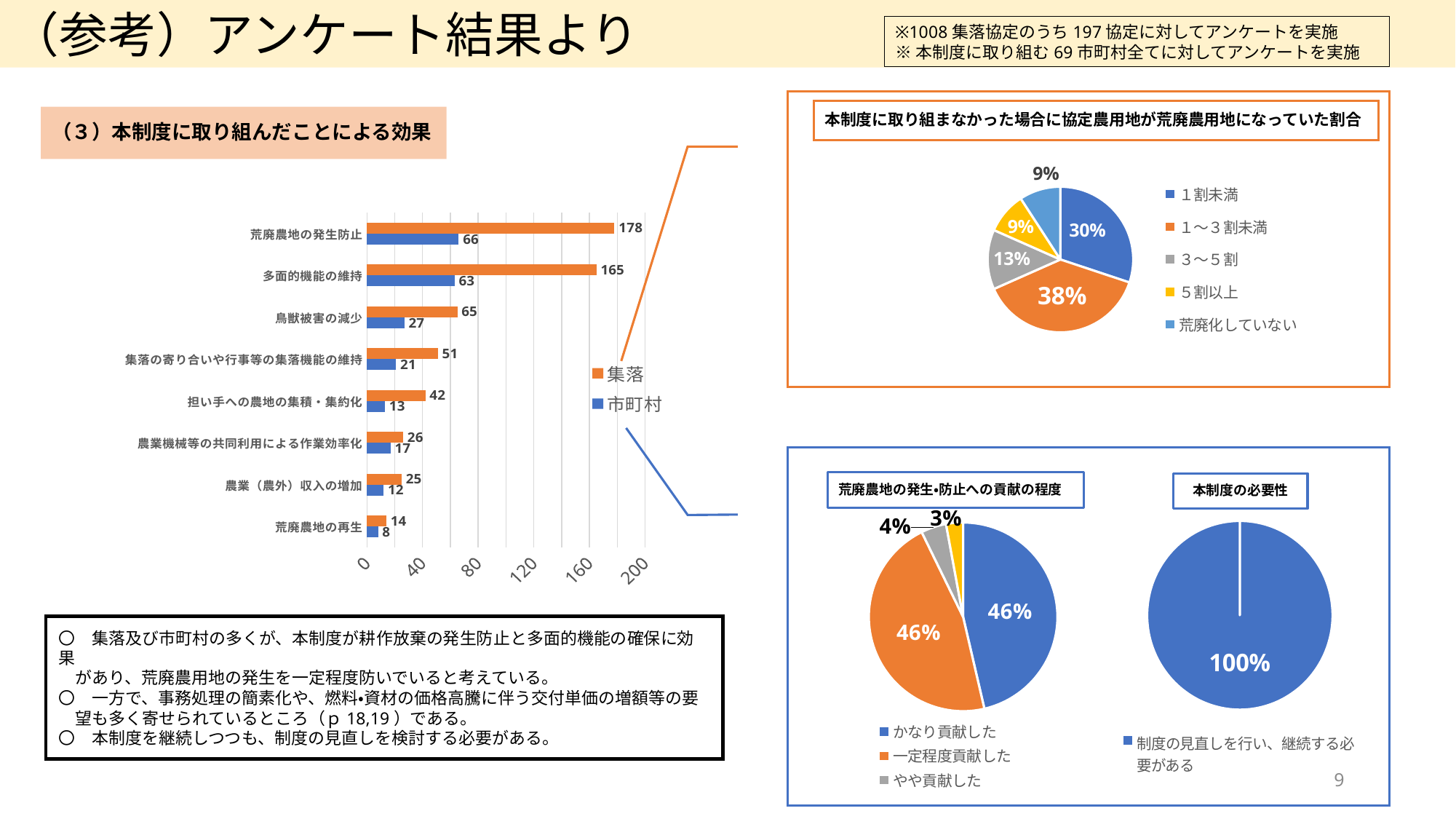
In the bar chart on the left, which category has the highest 集落 value? 荒廃農地の発生防止 In the pie chart titled 本制度の必要性, what share is 制度の見直しを行い、継続する必要がある? 100% In the pie chart titled 本制度に取り組まなかった場合に協定農用地が荒廃農用地になっていた割合, what share is 1〜3割未満? 38% What kind of chart is the chart on the left of the slide? bar chart In the bar chart on the left, which category has the lowest 市町村 value? 荒廃農地の再生 In the bar chart on the left, what is the value for 市町村 for 鳥獣被害の減少? 27 In the bar chart on the left, how many categories are shown? 8 In the bar chart on the left, how many series does the legend list? 2 In the bar chart on the left, what is the difference between the 集落 and 市町村 values for 多面的機能の維持? 102 In the pie chart titled 本制度に取り組まなかった場合に協定農用地が荒廃農用地になっていた割合, which category has the largest share? 1〜3割未満 In the bar chart on the left, what is the value for 集落 for 荒廃農地の発生防止? 178 In the pie chart titled 荒廃農地の発生・防止への貢献の程度, what share is やや貢献した? 4%